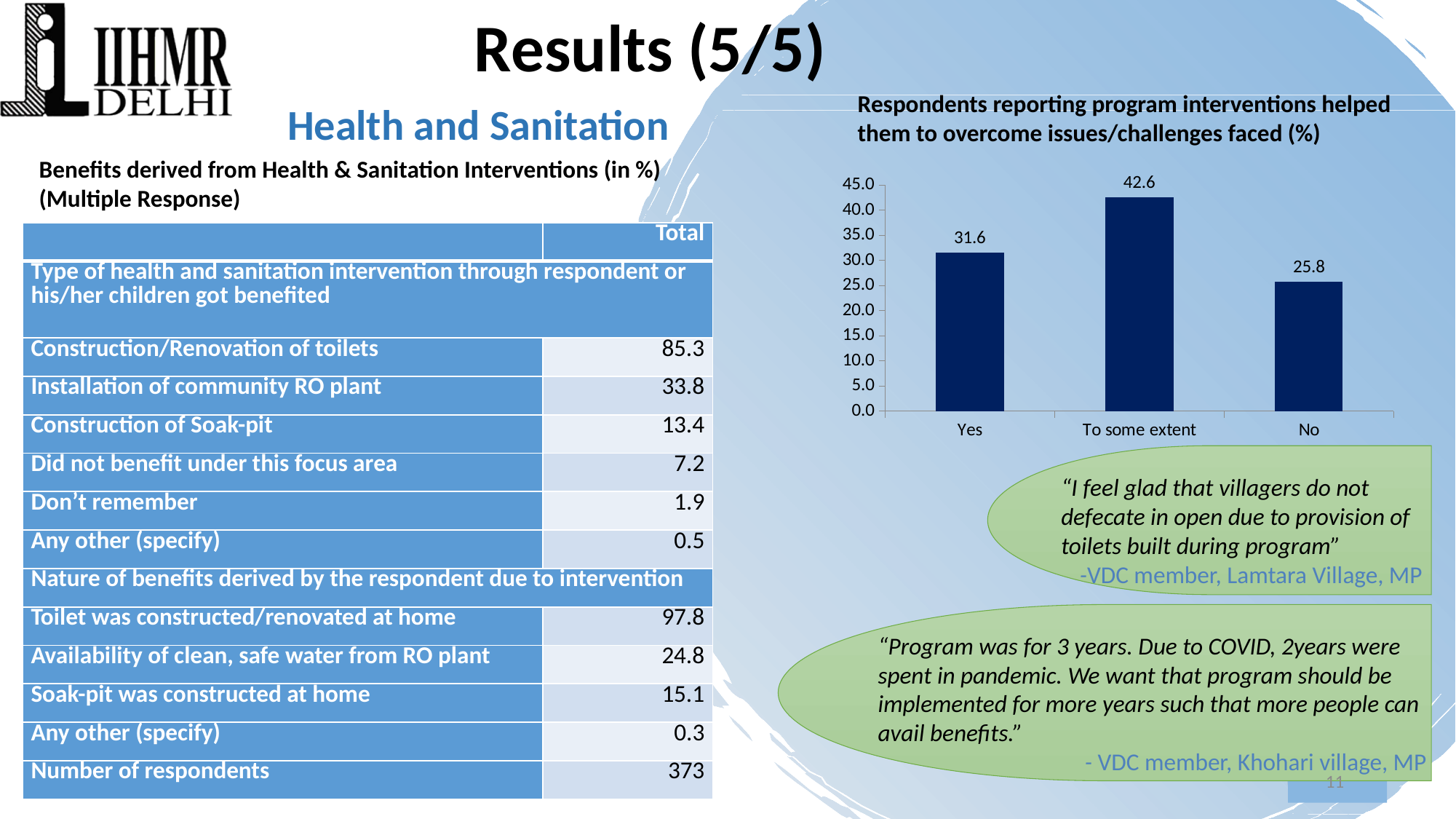
What is the title of the chart on the slide? Respondents reporting program interventions helped them to overcome issues/challenges faced (%) What is the difference between the values for "To some extent" and "Yes"? 11.0 Which category has the highest value in the chart? To some extent What is the value for "No" in the chart? 25.8 What is the difference between the values for "Yes" and "No"? 5.8 What is the value for "To some extent" in the chart? 42.6 What is the value for "Yes" in the chart? 31.6 How many categories are shown on the x axis of the chart? 3 Is the value for "To some extent" greater or less than 40.0? greater What kind of chart is shown on the slide? Bar chart Which is larger, the value for "Yes" or the value for "No"? Yes Which category has the lowest value in the chart? No